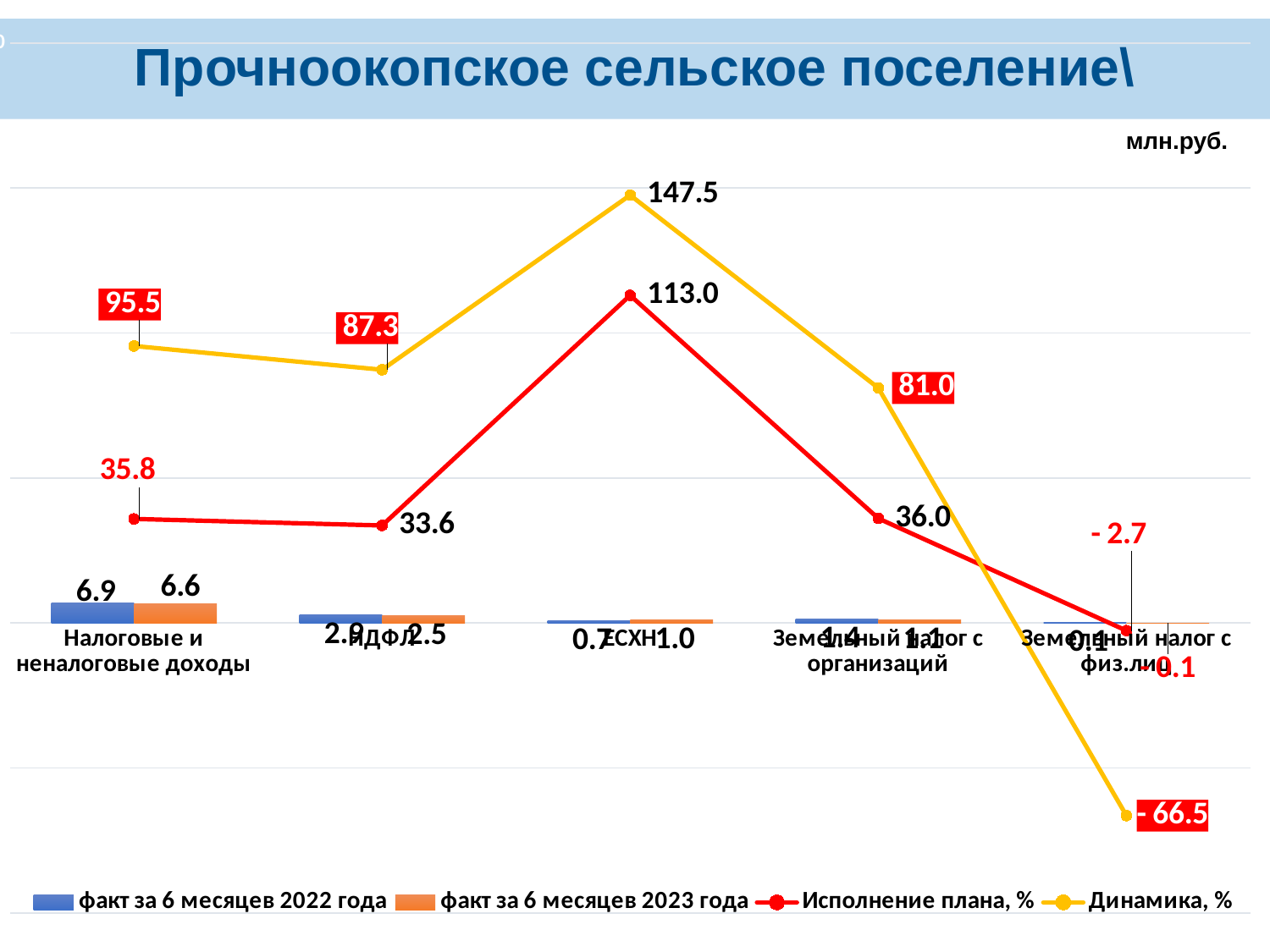
What is the value of Динамика, % for ЕСХН? 147.5 What is the value of Исполнение плана, % for Земельный налог с организаций? 36.0 Which is larger for Налоговые и неналоговые доходы: факт за 6 месяцев 2022 года or факт за 6 месяцев 2023 года? факт за 6 месяцев 2022 года How many series does the legend list? 4 What is the difference between Динамика, % and Исполнение плана, % for ЕСХН? 34.5 Which category has the lowest value of Динамика, %? Земельный налог с физ.лиц What is the value of факт за 6 месяцев 2023 года for Налоговые и неналоговые доходы? 6.6 Which category has the highest value of Исполнение плана, %? ЕСХН What is the value of Исполнение плана, % for Налоговые и неналоговые доходы? 35.8 How many categories are shown on the x axis? 5 What kind of chart is shown on the slide? Combined bar and line chart What is the value of Динамика, % for Земельный налог с физ.лиц? - 66.5